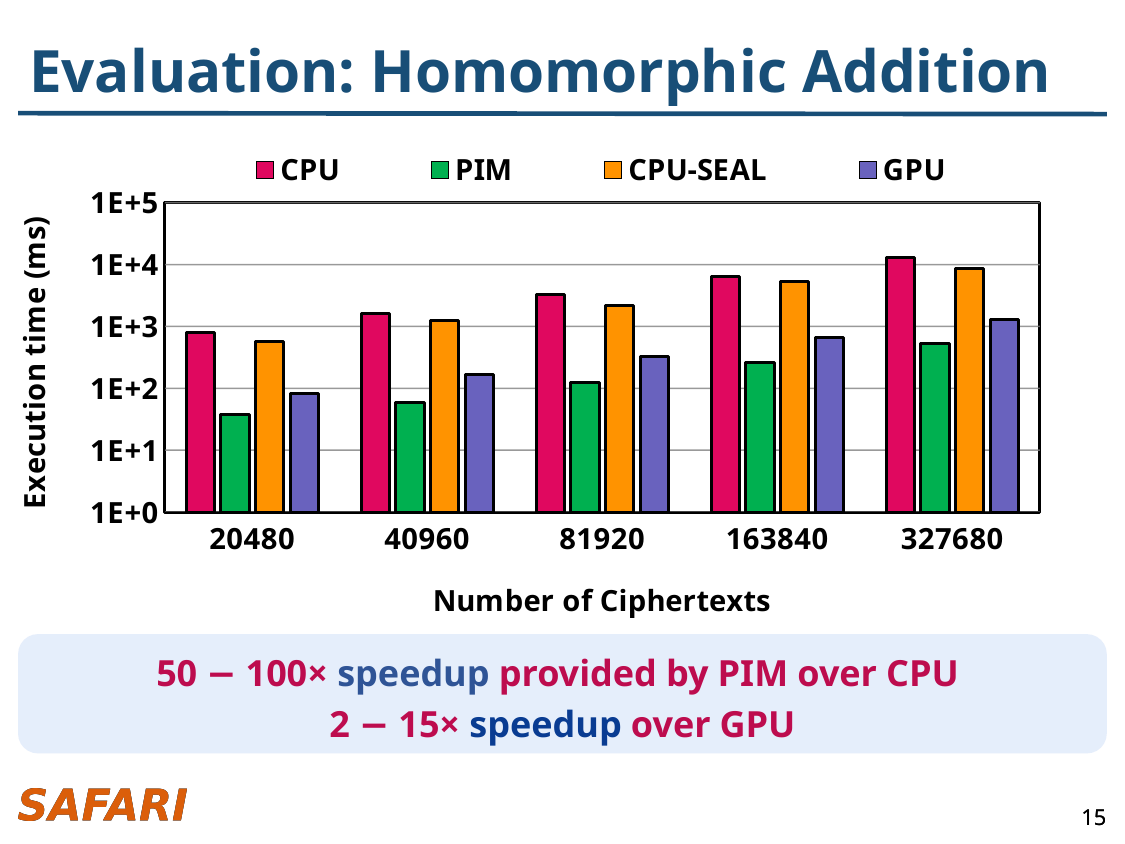
How many series does the legend list? 4 Is the PIM execution time at 20480 ciphertexts greater or less than 1E+2 ms? less Which series has the highest execution time at 327680 ciphertexts? CPU What is the label of the y axis? Execution time (ms) At which number of ciphertexts is the CPU execution time highest? 327680 Is the CPU execution time at 327680 ciphertexts greater or less than 1E+4 ms? greater Does the PIM execution time rise or fall as the number of ciphertexts increases? rise How many Number of Ciphertexts categories are shown on the x axis? 5 What kind of chart is shown on the slide? bar chart Which series has the lowest execution time at 327680 ciphertexts? PIM Which is larger at 163840 ciphertexts, the CPU execution time or the GPU execution time? CPU